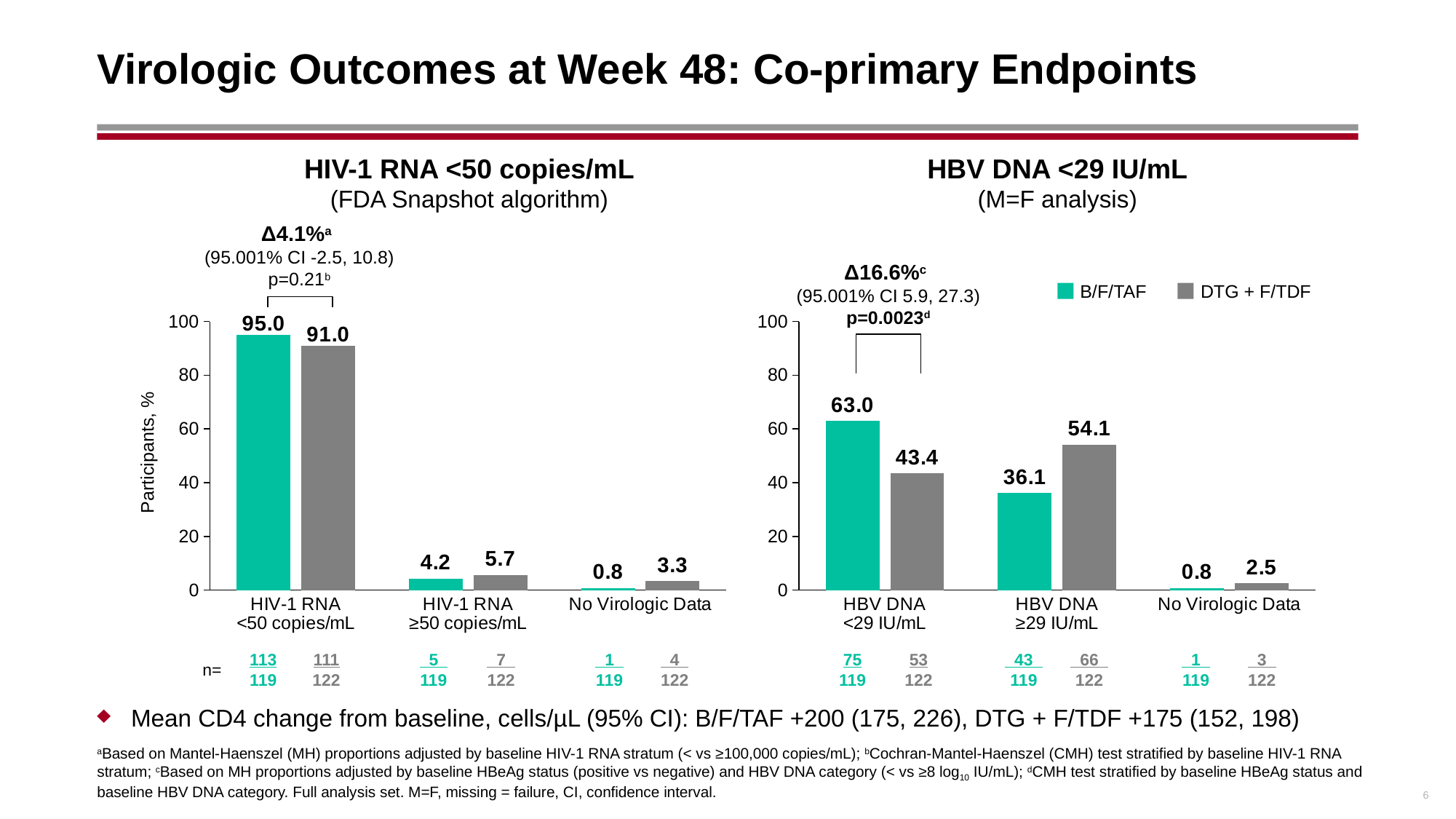
What kind of chart is the HBV DNA <29 IU/mL chart? Bar chart In the HIV-1 RNA <50 copies/mL chart, which category has the lowest DTG + F/TDF value? No Virologic Data In the HBV DNA <29 IU/mL chart, which series has the larger value in the HBV DNA ≥29 IU/mL category? DTG + F/TDF In the HBV DNA <29 IU/mL chart, what is the value for B/F/TAF in the HBV DNA ≥29 IU/mL category? 36.1 In the HIV-1 RNA <50 copies/mL chart, what is the value for B/F/TAF in the HIV-1 RNA <50 copies/mL category? 95.0 In the HIV-1 RNA <50 copies/mL chart, what is the value for DTG + F/TDF in the No Virologic Data category? 3.3 In the HBV DNA <29 IU/mL chart, what is the value for DTG + F/TDF in the HBV DNA <29 IU/mL category? 43.4 In the HBV DNA <29 IU/mL chart, what is the difference between the B/F/TAF and DTG + F/TDF values in the HBV DNA <29 IU/mL category? 19.6 What is the y-axis label of the HIV-1 RNA <50 copies/mL chart? Participants, % In the HBV DNA <29 IU/mL chart, which category has the highest B/F/TAF value? HBV DNA <29 IU/mL How many series does the legend list? 2 How many categories are shown on the x axis of the HIV-1 RNA <50 copies/mL chart? 3